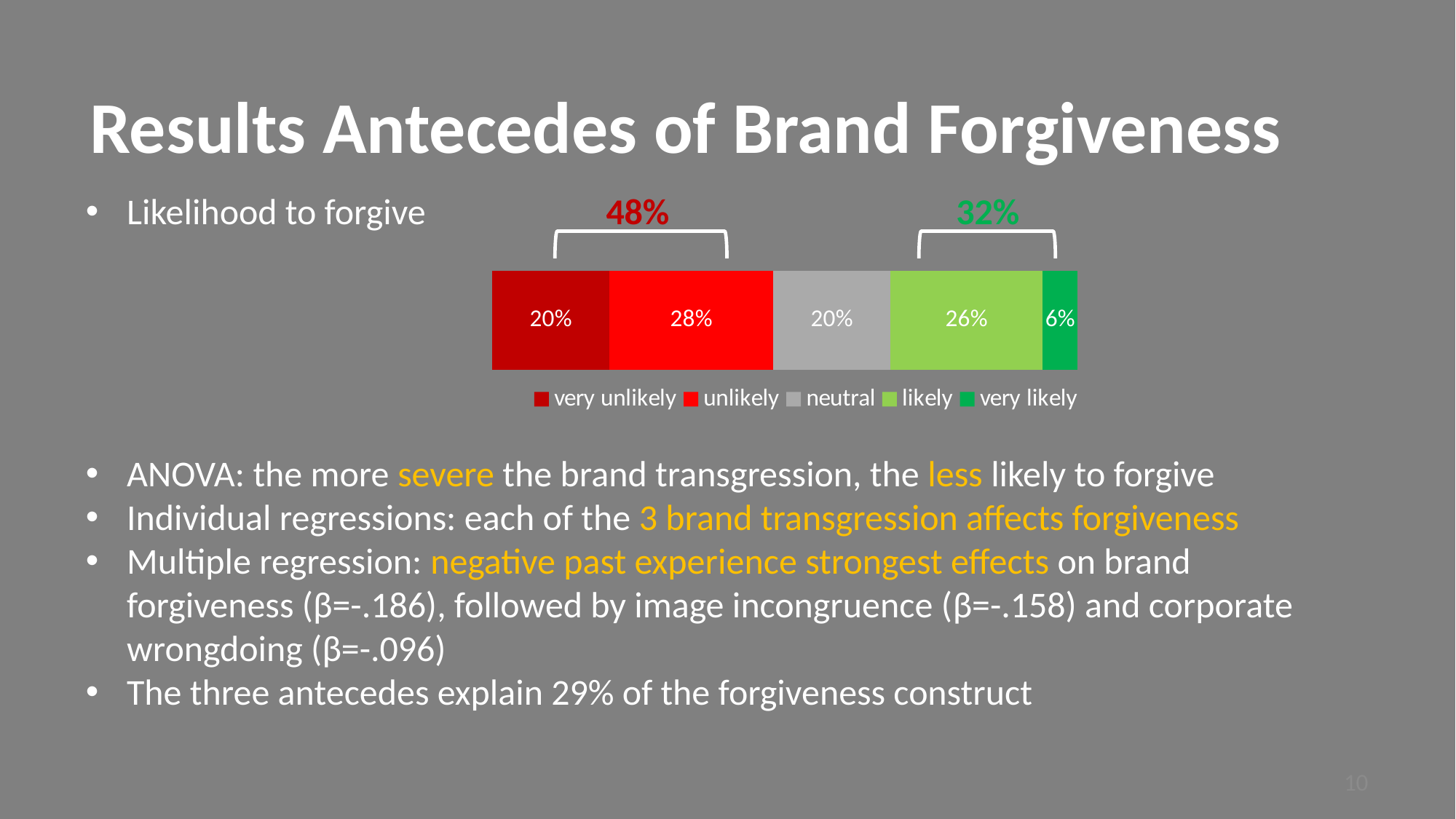
What percentage of respondents are 'neutral' about forgiving? 20% What is the combined share of 'likely' and 'very likely' responses, as annotated above the bar? 32% What colour represents the 'neutral' category in the chart? grey What kind of chart is used to show likelihood to forgive? stacked bar chart What is the combined share of 'very unlikely' and 'unlikely' responses, as annotated above the bar? 48% Which response category has the smallest share in the likelihood to forgive chart? very likely What percentage of respondents are 'very likely' to forgive? 6% What is the difference between the 'likely' and 'very likely' shares? 20% What percentage of respondents are 'unlikely' to forgive? 28% Which response category has the largest share in the likelihood to forgive chart? unlikely Which is larger, the 'unlikely' share or the 'likely' share? unlikely How many series does the legend list? 5